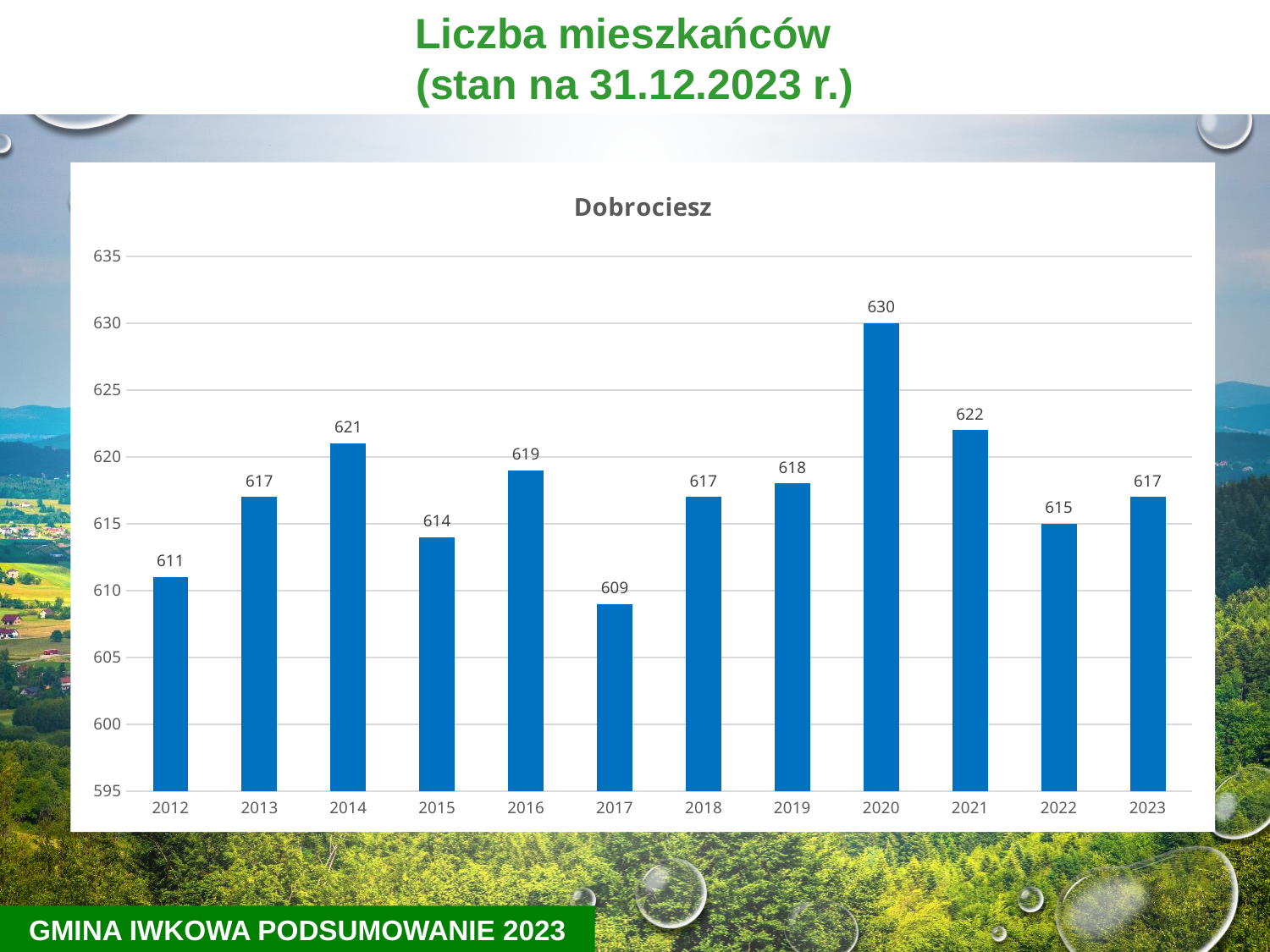
What is the value for 2012 in the Dobrociesz chart? 611 Which year has the highest value in the Dobrociesz chart? 2020 What is the title of the chart? Dobrociesz How many years are shown on the x axis of the chart? 12 What is the value for 2020 in the Dobrociesz chart? 630 Which is larger, the value for 2014 or the value for 2016? 2014 What is the value for 2017 in the Dobrociesz chart? 609 What kind of chart is shown on the slide? bar chart What is the difference between the values for 2021 and 2022? 7 What is the difference between the values for 2020 and 2017? 21 Is the value for 2015 greater or less than 610? greater Which year has the lowest value in the Dobrociesz chart? 2017